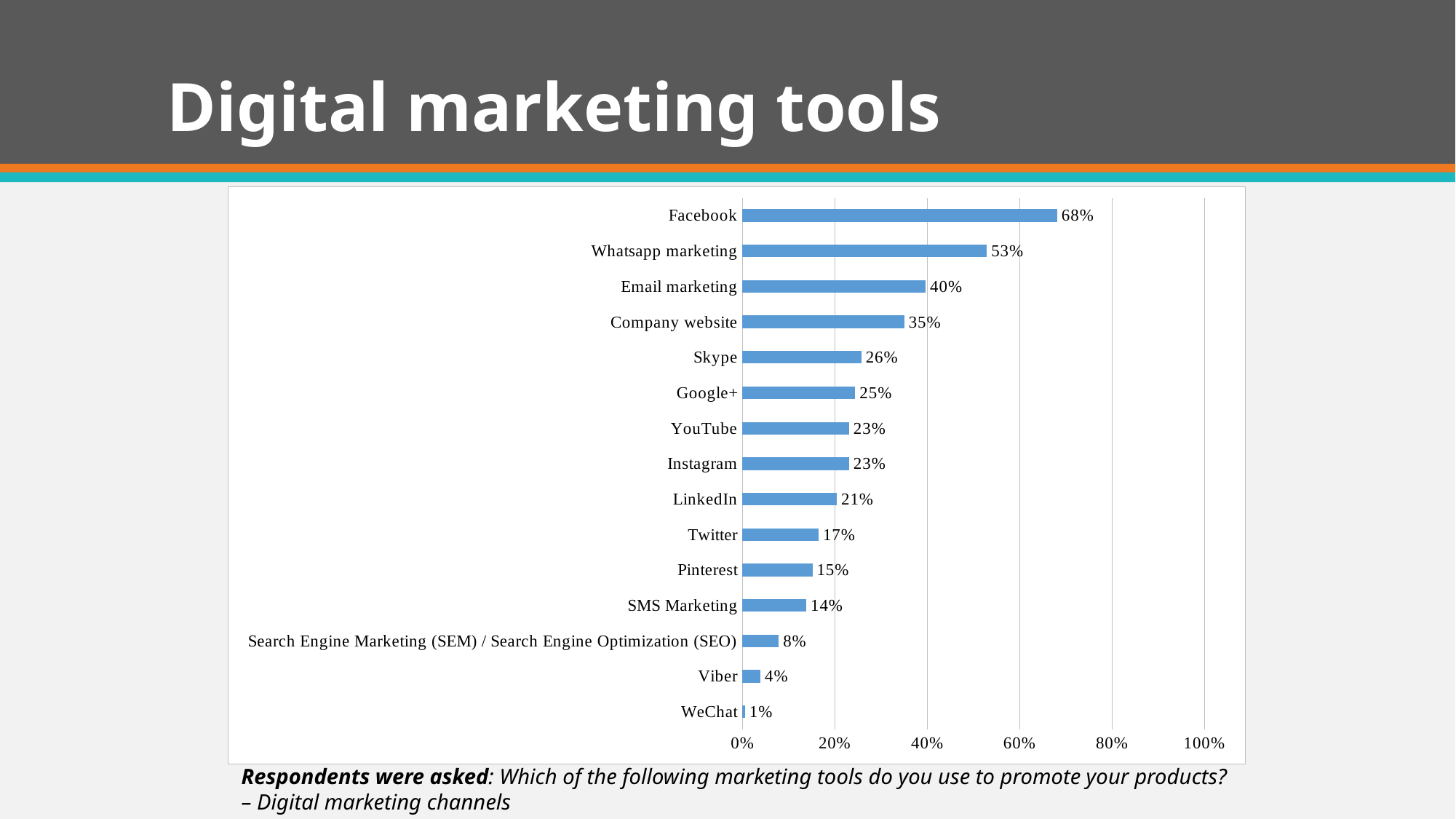
What is the value shown for Email marketing? 40% Which has a larger value, Twitter or Pinterest? Twitter What percentage of respondents use Facebook to promote their products? 68% What is the difference between the values for Facebook and Whatsapp marketing? 15% What is the highest value shown on the horizontal axis of the chart? 100% What is the difference between the values for Company website and Skype? 9% Which marketing tool has the lowest value in the chart? WeChat Which marketing tool has the highest value in the chart? Facebook Which has a larger value, LinkedIn or Google+? Google+ What type of chart is shown on the slide? Bar chart What is the value shown for Search Engine Marketing (SEM) / Search Engine Optimization (SEO)? 8% How many marketing tools are listed in the chart? 15